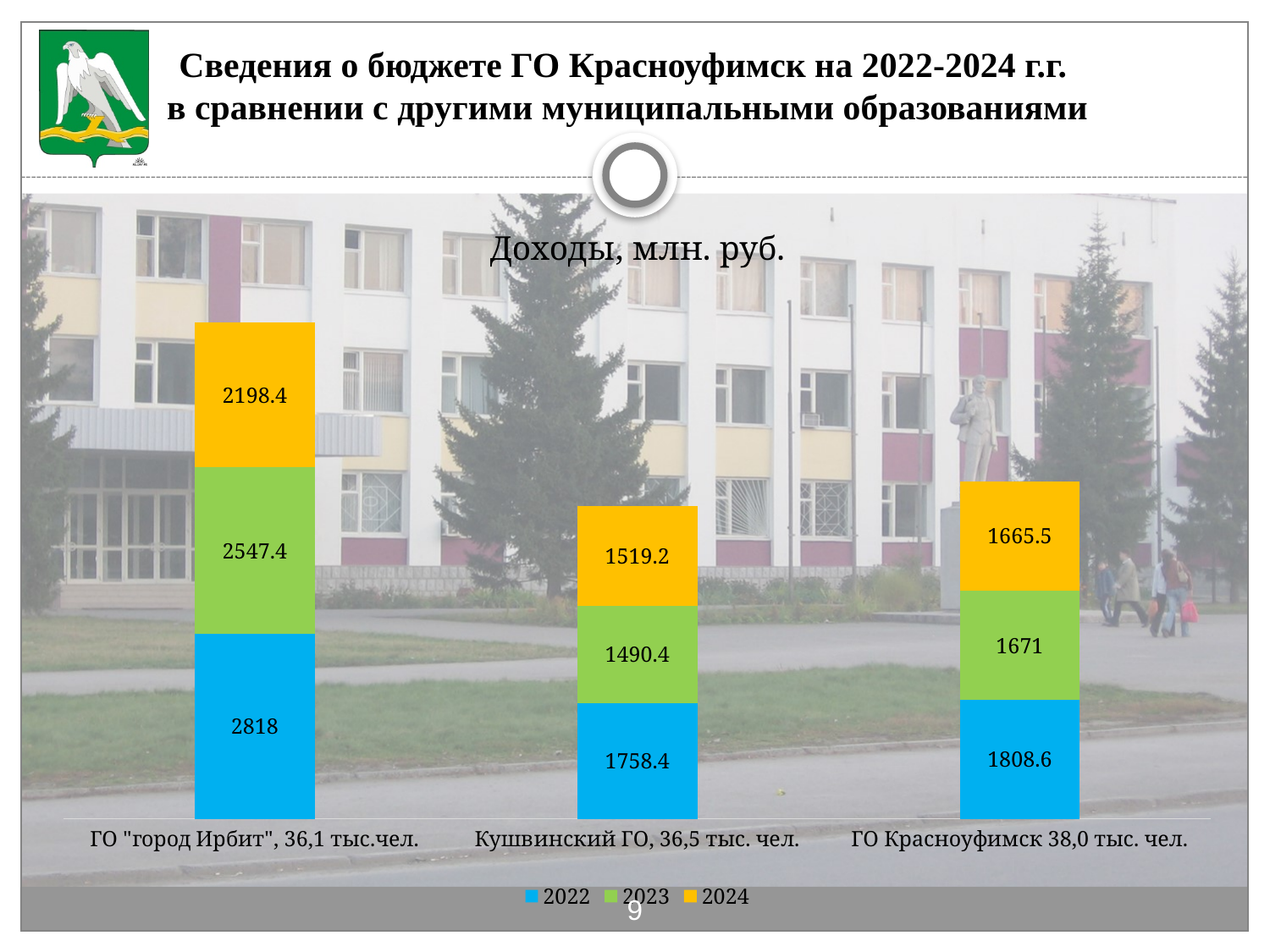
Which municipality has the highest 2022 value? ГО "город Ирбит" What is the total of the stacked bar for ГО Красноуфимск? 5145.1 What is the 2023 value for ГО Красноуфимск? 1671 What is the 2022 value for ГО "город Ирбит"? 2818 What type of chart is shown? Stacked bar chart Which municipality has the lowest 2024 value? Кушвинский ГО How many series does the legend list? 3 What is the total of the stacked bar for Кушвинский ГО? 4768 What is the difference between the 2022 values for ГО "город Ирбит" and ГО Красноуфимск? 1009.4 What is the 2024 value for Кушвинский ГО? 1519.2 How many municipalities are shown on the x axis? 3 Which is larger: the 2023 value for Кушвинский ГО or the 2023 value for ГО Красноуфимск? ГО Красноуфимск